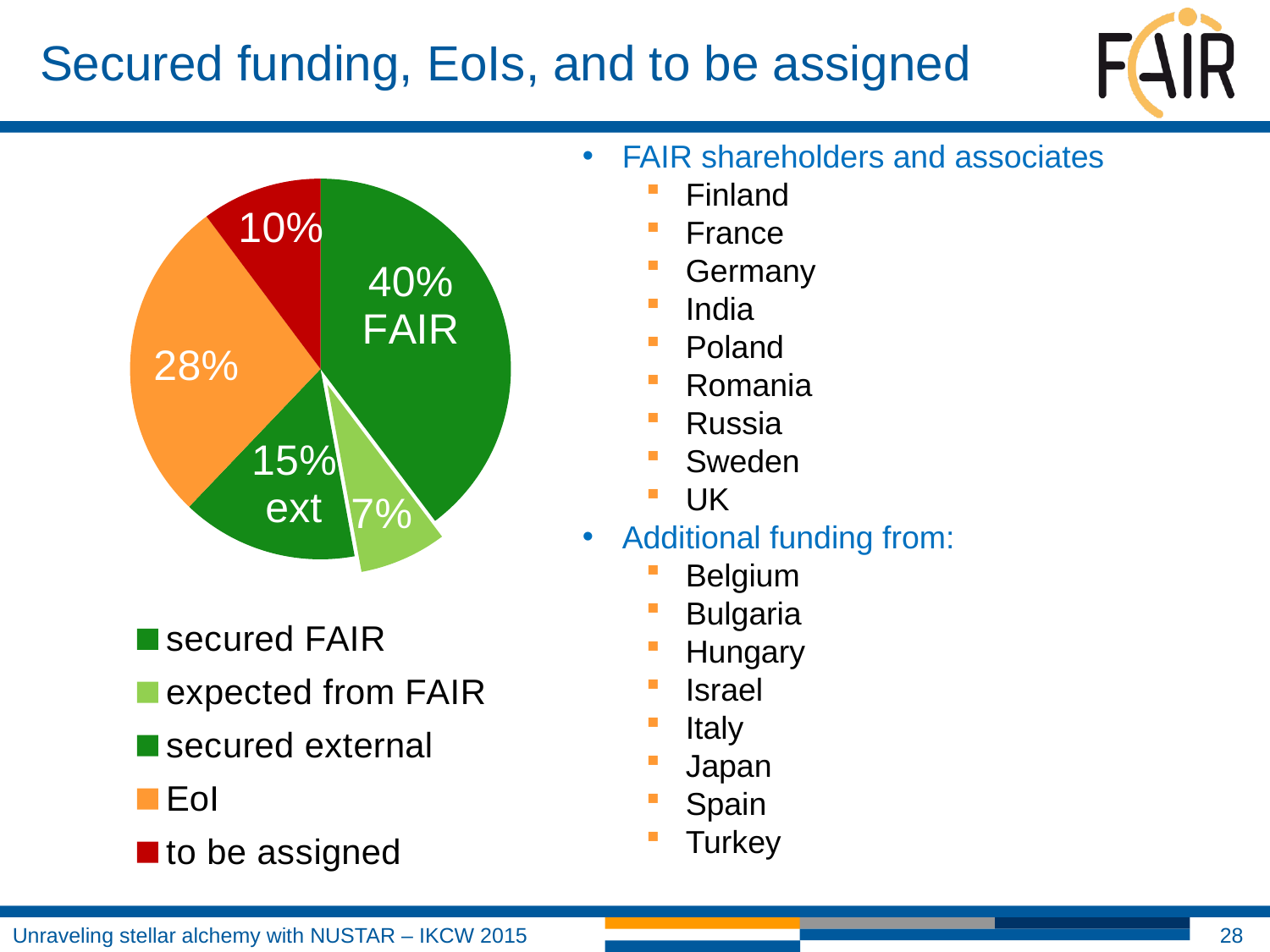
What is the difference in percentage points between the "secured FAIR" slice and the "EoI" slice? 12 Which category has the smallest slice of the pie? expected from FAIR What share of the pie is labelled "secured FAIR"? 40% What share of the pie is labelled "expected from FAIR"? 7% What share of the pie is labelled "secured external"? 15% Which category has the largest slice of the pie? secured FAIR How many entries does the legend list? 5 What kind of chart is shown on the slide? pie chart Which is larger, the "secured external" slice or the "to be assigned" slice? secured external How many slices does the pie chart have? 5